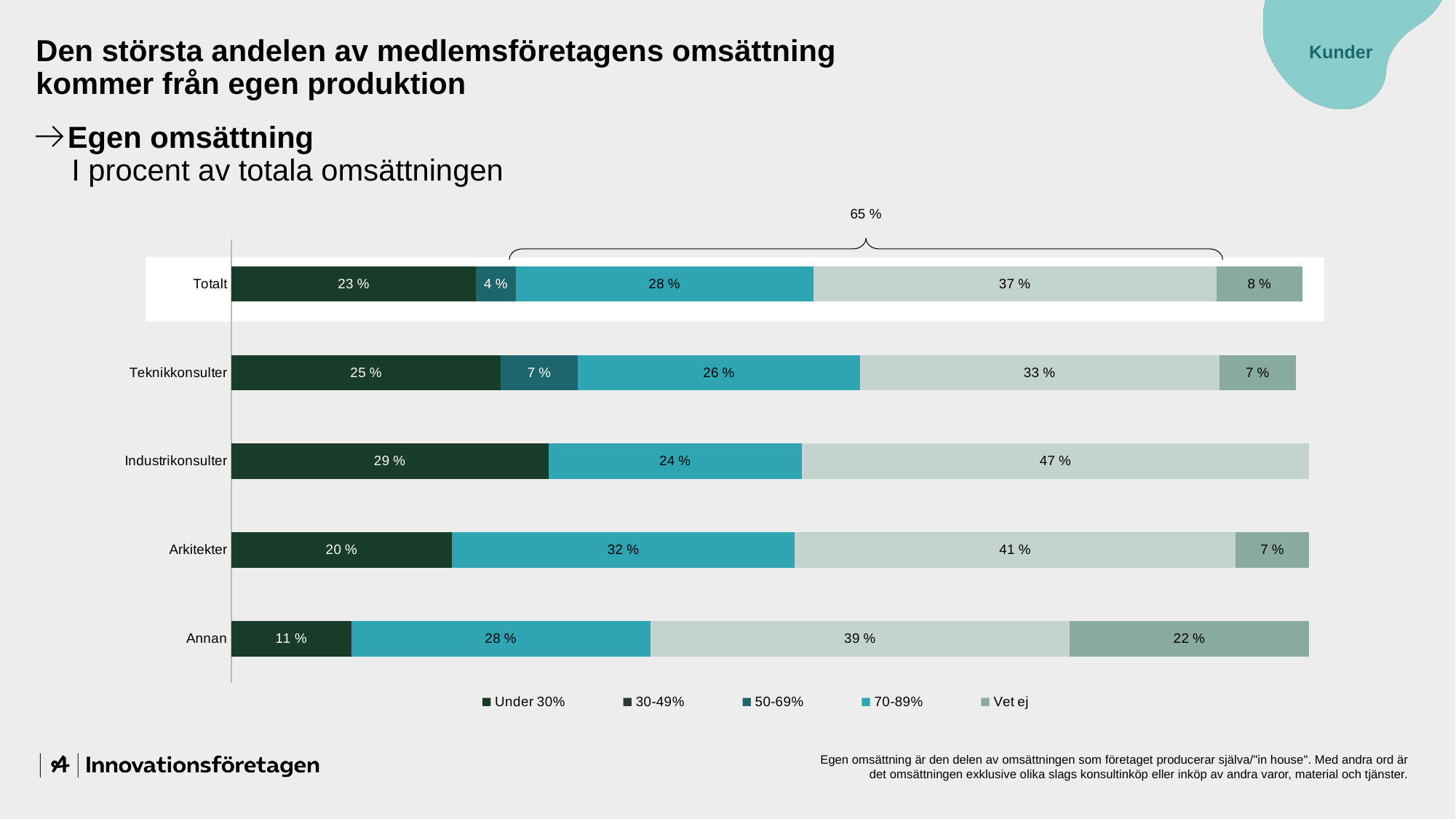
What is the value of the rightmost segment of the Annan bar? 22 % How many categories (bars) are shown in the chart? 5 Which category has the largest leftmost (darkest) segment? Industrikonsulter How many series does the legend list? 5 Which is larger: the teal segment of Arkitekter (32 %) or the teal segment of Annan (28 %)? Arkitekter What is the value of the second segment (4 %-sized dark teal) of the Totalt bar? 4 % What is the total of all labelled segments in the Teknikkonsulter bar? 98 % Which category has the smallest leftmost (darkest) segment? Annan What is the value of the leftmost (darkest) segment of the Industrikonsulter bar? 29 % What percentage is shown in the bracket annotation above the Totalt bar? 65 % What kind of chart is shown on the slide? Stacked bar chart What is the difference between the leftmost segment of Teknikkonsulter (25 %) and the leftmost segment of Totalt (23 %)? 2 %